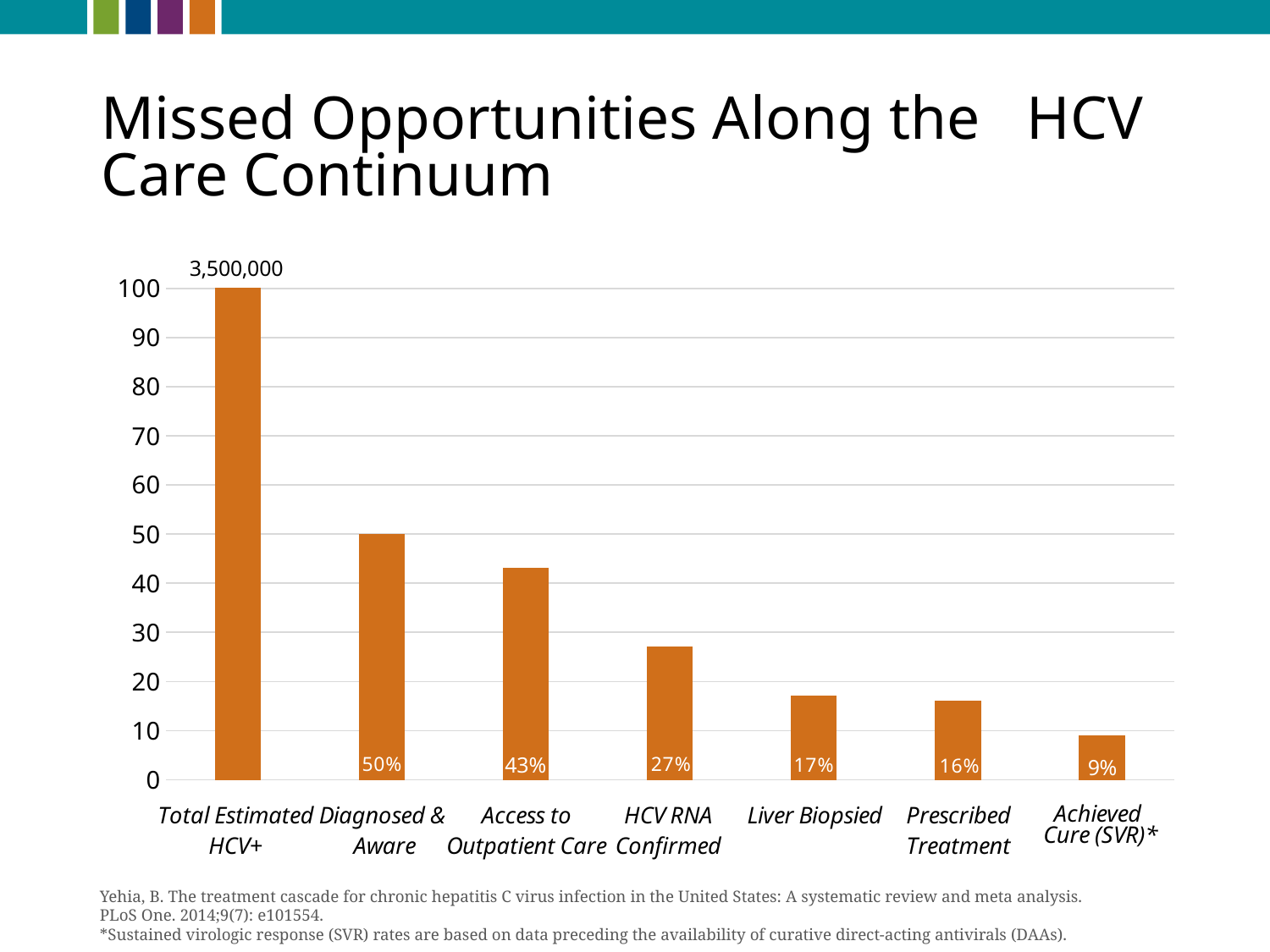
What value is shown for HCV RNA Confirmed? 27% What value is shown for Diagnosed & Aware? 50% Which is larger, the value for Liver Biopsied or the value for Achieved Cure (SVR)*? Liver Biopsied Do the values rise or fall moving from left to right along the x axis? Fall How many categories are shown on the x axis? 7 Which category has the tallest bar? Total Estimated HCV+ What number is printed above the Total Estimated HCV+ bar? 3,500,000 Which category has the lowest value? Achieved Cure (SVR)* What kind of chart is shown on the slide? Bar chart What is the difference between the values for Diagnosed & Aware and Access to Outpatient Care? 7% What value is shown for Access to Outpatient Care? 43% What value is shown for Achieved Cure (SVR)*? 9%